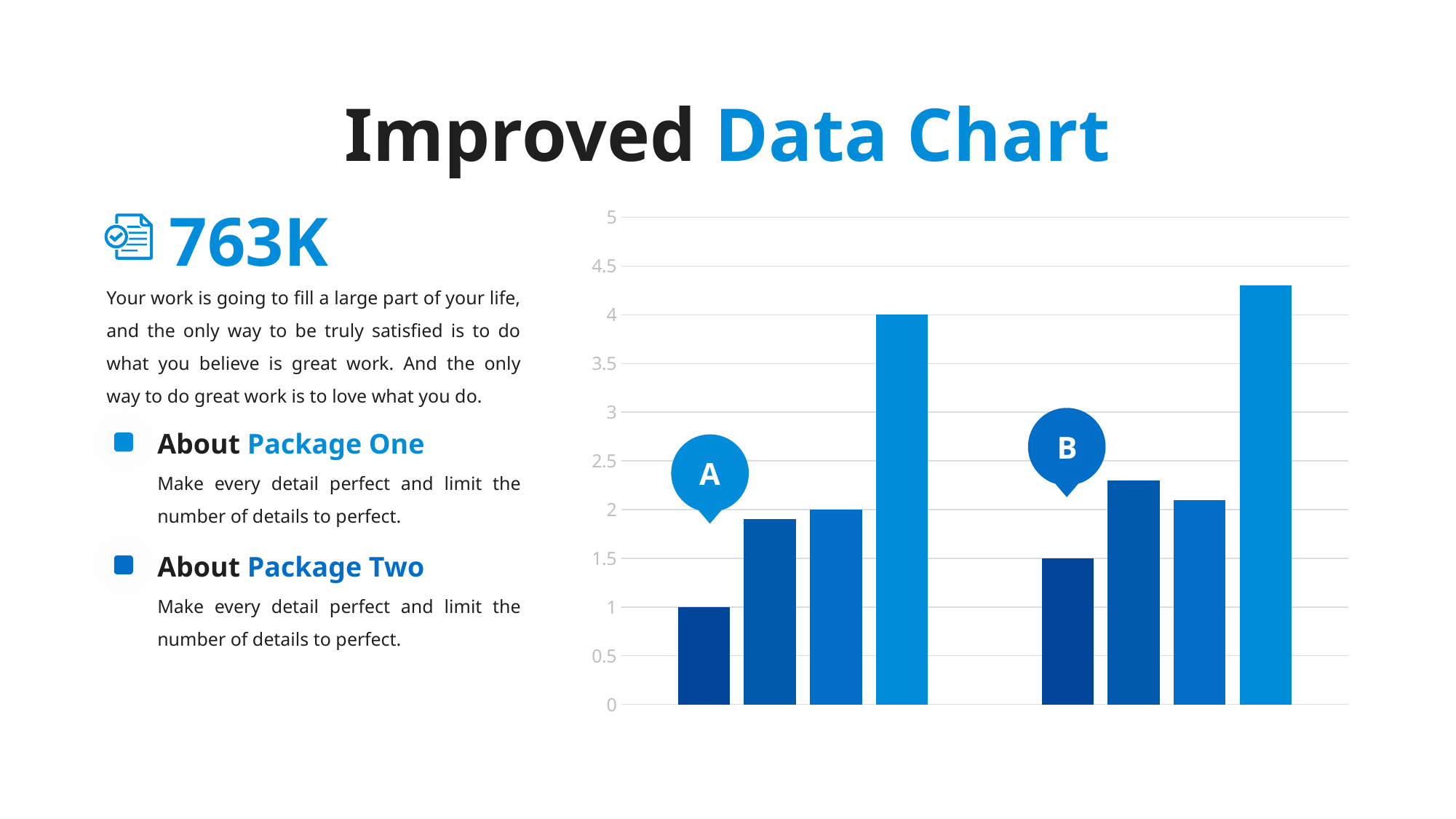
What is the value of the tallest bar in group A? 4 Which is larger: the leftmost bar in group A or the leftmost bar in group B? the leftmost bar in group B What is the difference between the tallest bar in group A and the leftmost bar in group A? 3 How many labelled groups of bars does the chart show? 2 What is the value of the leftmost (darkest) bar in group A? 1 Is the value of the tallest bar in group B greater or less than 4? greater What is the value of the third bar from the left in group A? 2 How many bars are in each group of the chart? 4 What is the value of the leftmost (darkest) bar in group B? 1.5 Which group, A or B, contains the tallest bar in the chart? B Is the value of the second bar from the left in group B greater or less than 2? greater What kind of chart is shown on the slide? bar chart